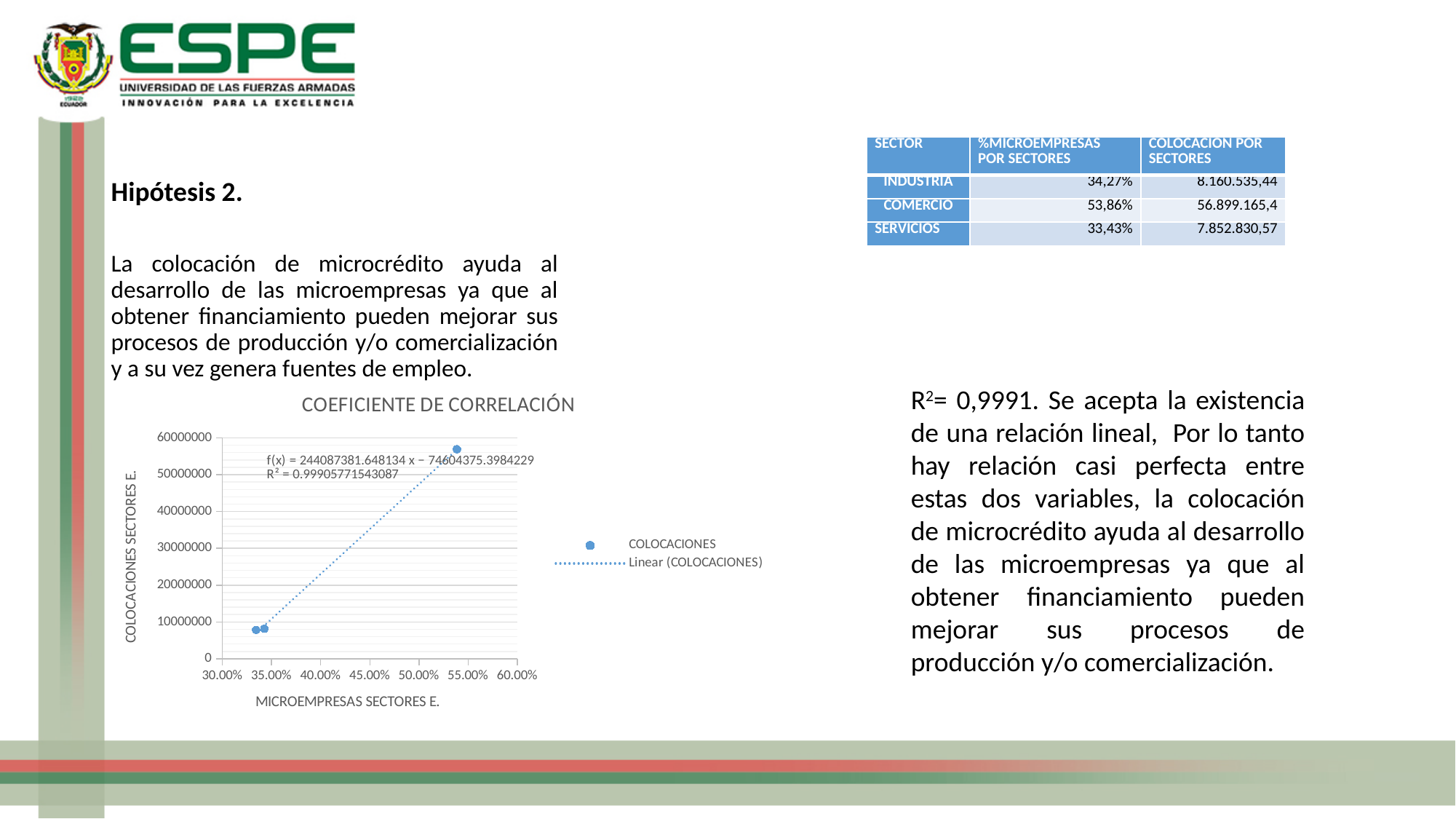
What kind of chart is shown under the title COEFICIENTE DE CORRELACIÓN? Scatter chart In the COEFICIENTE DE CORRELACIÓN chart, are the x values of the two lowest points greater or less than 40.00%? less What R² value is printed on the COEFICIENTE DE CORRELACIÓN chart? R² = 0.99905771543087 How many data points are plotted in the COEFICIENTE DE CORRELACIÓN chart? 3 What is the title of the x axis of the COEFICIENTE DE CORRELACIÓN chart? MICROEMPRESAS SECTORES E. In the COEFICIENTE DE CORRELACIÓN chart, are the y values of the two lowest points greater or less than 10000000? less In the COEFICIENTE DE CORRELACIÓN chart, do the plotted values rise or fall as the x-axis value increases? Rise In the COEFICIENTE DE CORRELACIÓN chart, is the x value of the highest point greater or less than 50.00%? greater How many entries does the legend of the COEFICIENTE DE CORRELACIÓN chart list? 2 What is the second entry in the legend of the COEFICIENTE DE CORRELACIÓN chart? Linear (COLOCACIONES)